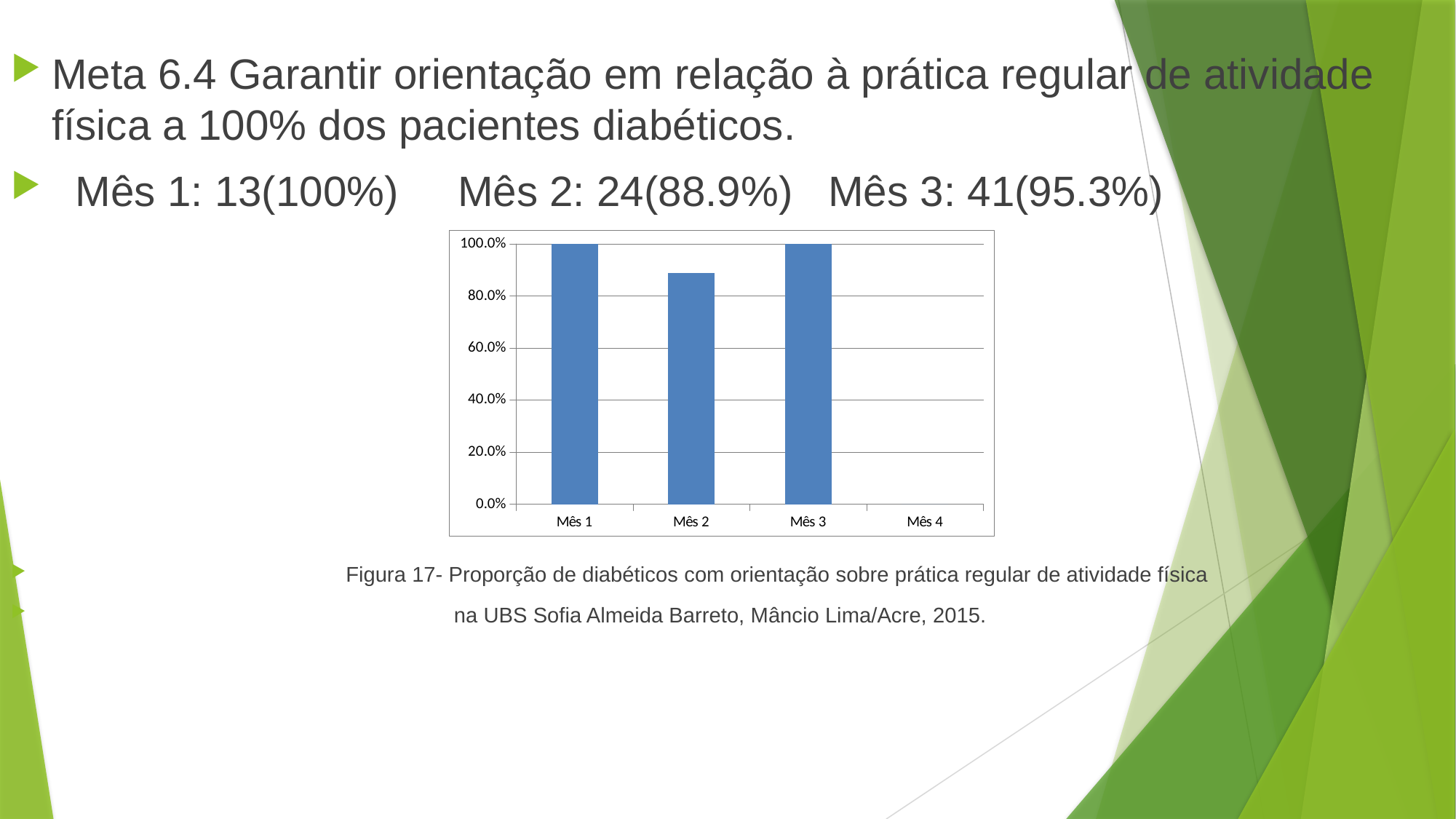
What is the value of the bar for Mês 1? 100.0% What is the difference between the proportions for Mês 1 and Mês 2? 11.1% How many categories are shown on the x axis of the chart? 4 What proportion does the slide give for Mês 2? 88.9% Is the bar for Mês 3 greater or less than 80.0%? greater Among the months with a bar, which has the lowest value? Mês 2 What kind of chart is shown on the slide? bar chart Which month has the highest bar in the chart? Mês 1 and Mês 3 (tied at 100.0%) Which category on the x axis has no bar? Mês 4 Which is larger, the bar for Mês 2 or the bar for Mês 3? Mês 3 Is the bar for Mês 2 greater or less than 80.0%? greater What proportion does the slide give for Mês 3? 95.3%